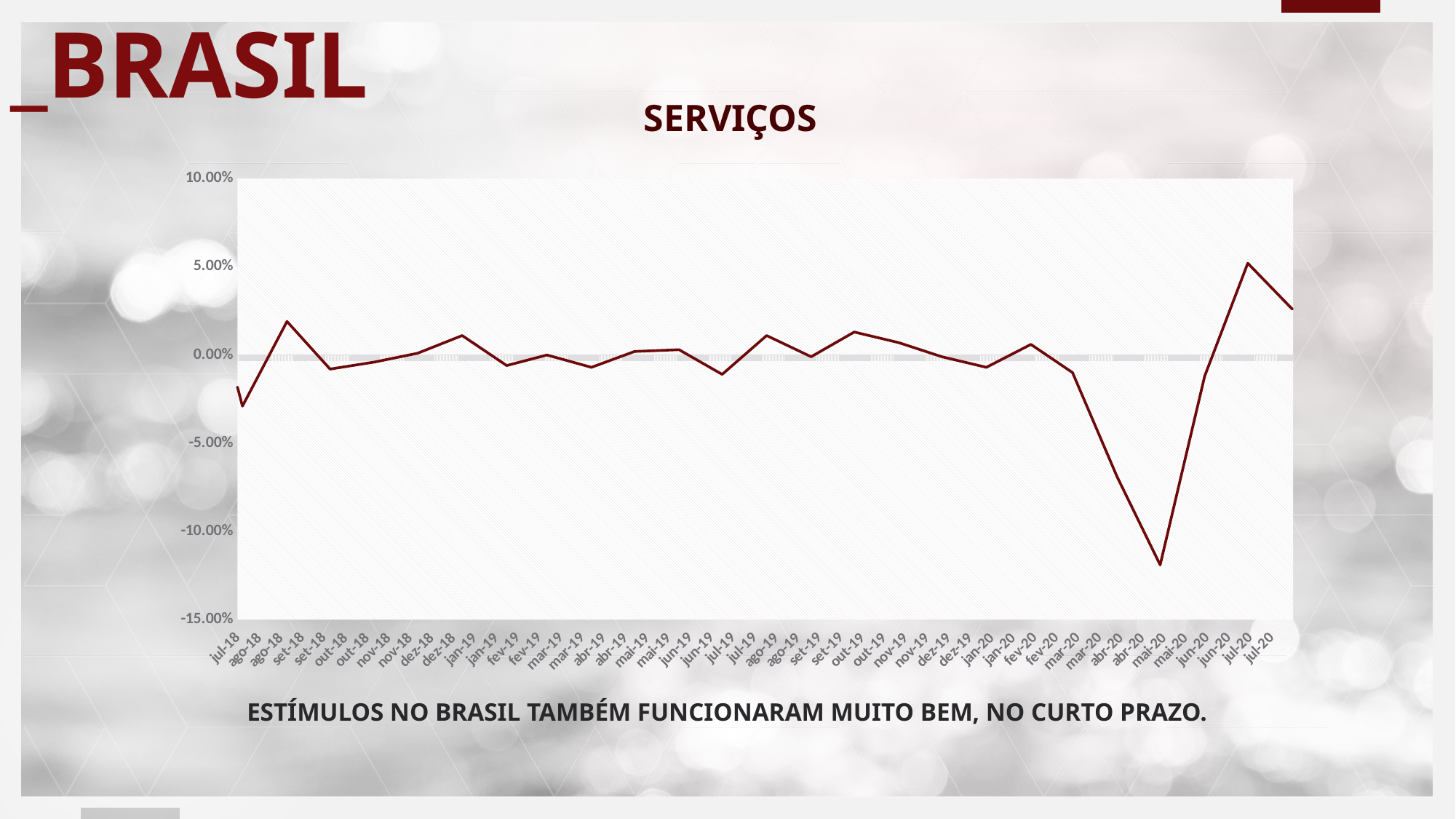
Which month has the highest value on the chart? jun-20 Which is larger, the value for set-18 or the value for jul-18? set-18 What is the title of the chart? SERVIÇOS What kind of chart is shown on the slide? line chart Which month has the lowest value on the chart? abr-20 Is the value for abr-20 greater or less than -5.00%? less Is the value for mai-20 greater or less than -10.00%? greater Is the value for jul-18 greater or less than 0.00%? less Does the line rise or fall between mai-20 and jul-20? rise Which is larger, the value for jul-20 or the value for mai-20? jul-20